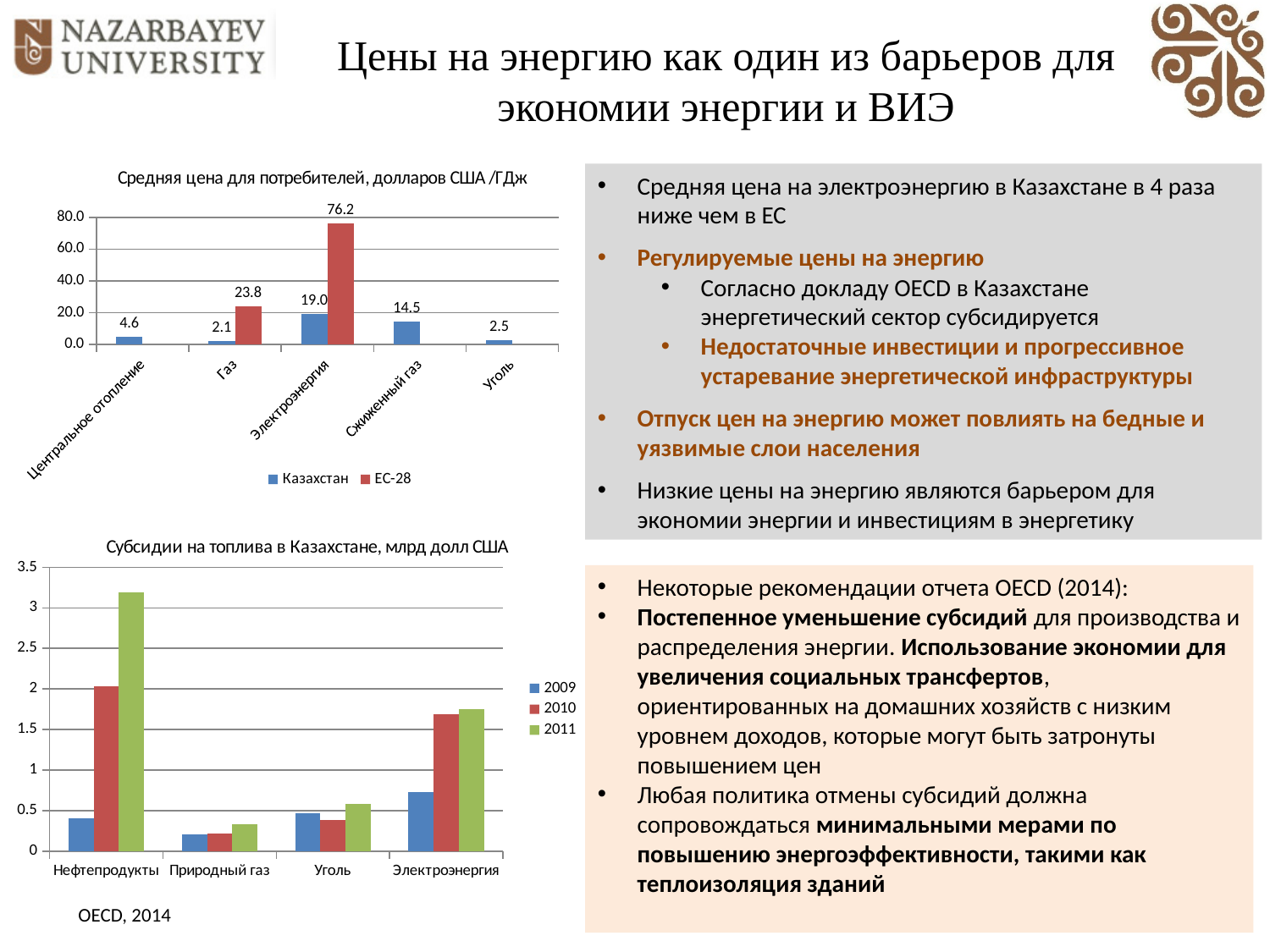
In the chart 'Субсидии на топлива в Казахстане, млрд долл США', which category has the highest value for 2011? Нефтепродукты In the chart 'Средняя цена для потребителей, долларов США /ГДж', how many categories are shown on the x axis? 5 In the chart 'Средняя цена для потребителей, долларов США /ГДж', which category has the highest value for Казахстан? Электроэнергия In the chart 'Средняя цена для потребителей, долларов США /ГДж', which category has the lowest value for Казахстан? Газ In the chart 'Субсидии на топлива в Казахстане, млрд долл США', do the values for Нефтепродукты rise or fall from 2009 to 2011? rise What kind of chart is 'Субсидии на топлива в Казахстане, млрд долл США'? bar chart In the chart 'Субсидии на топлива в Казахстане, млрд долл США', how many series does the legend list? 3 In the chart 'Средняя цена для потребителей, долларов США /ГДж', what is the value for ЕС-28 for Электроэнергия? 76.2 In the chart 'Субсидии на топлива в Казахстане, млрд долл США', is the 2011 value for Нефтепродукты greater or less than 3? greater In the chart 'Средняя цена для потребителей, долларов США /ГДж', how many series does the legend list? 2 In the chart 'Средняя цена для потребителей, долларов США /ГДж', what is the difference between the ЕС-28 and Казахстан values for Газ? 21.7 In the chart 'Средняя цена для потребителей, долларов США /ГДж', what is the value for Казахстан for Электроэнергия? 19.0